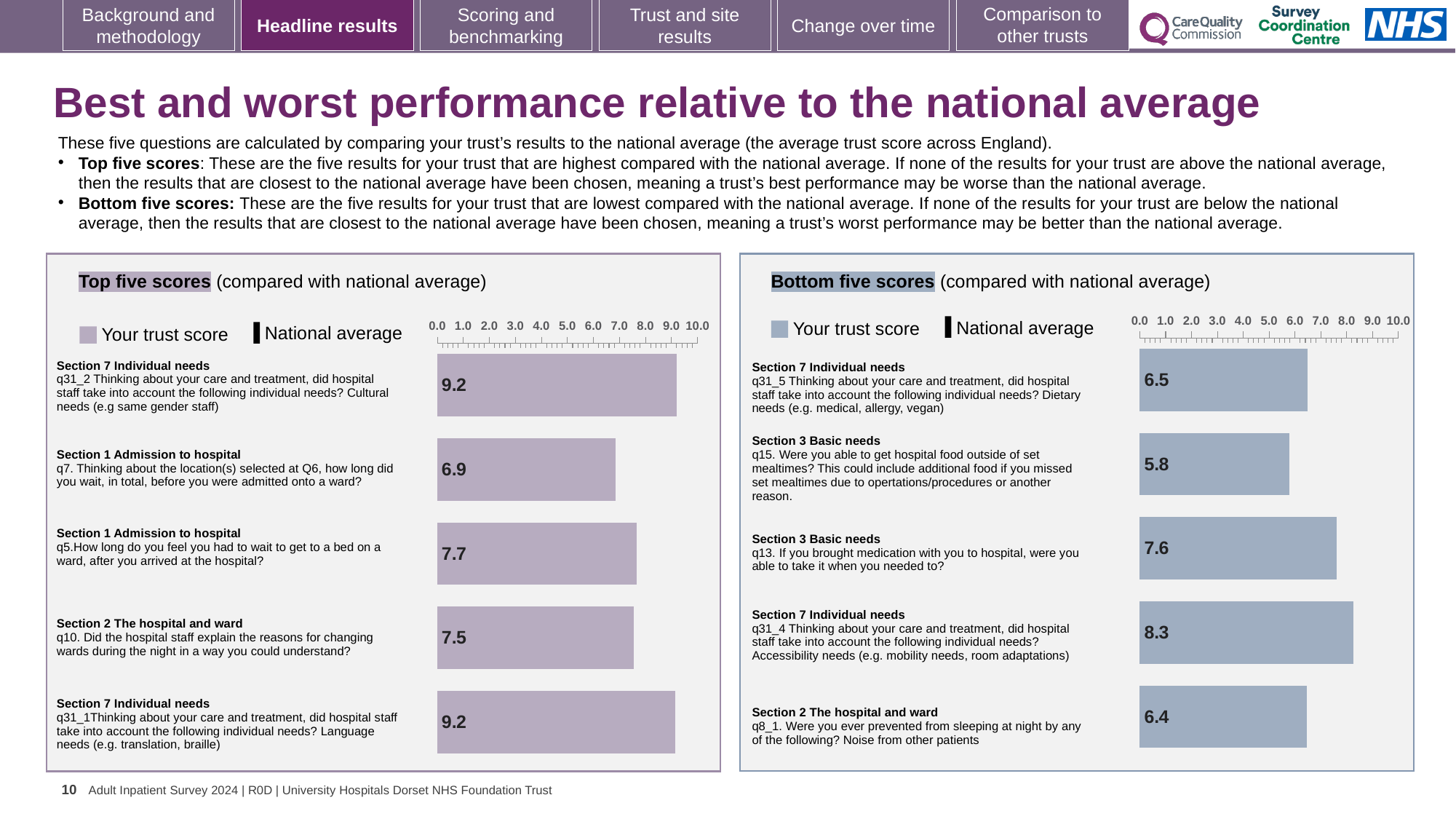
How many bars are plotted in the Top five scores chart? 5 In the Bottom five scores chart, which question has the lowest trust score? q15 (hospital food outside of set mealtimes) In the Top five scores chart, what is the trust score for q10 (did staff explain the reasons for changing wards during the night)? 7.5 In the Bottom five scores chart, what is the trust score for q13 (able to take medication you brought when you needed to)? 7.6 In the Bottom five scores chart, what is the trust score for q8_1 (prevented from sleeping by noise from other patients)? 6.4 In the Bottom five scores chart, which question has the highest trust score? q31_4 (accessibility needs) In the Top five scores chart, what is the trust score for q7 (how long did you wait before being admitted onto a ward)? 6.9 In the Bottom five scores chart, what is the difference between the trust score for q31_4 and the trust score for q15? 2.5 In the Bottom five scores chart, which has the larger trust score: q31_5 (dietary needs) or q8_1 (noise from other patients)? q31_5 (dietary needs) In the Top five scores chart, which question has the lowest trust score? q7 (how long did you wait before being admitted onto a ward) What type of chart is the Bottom five scores chart? Bar chart In the Top five scores chart, what is the difference between the trust score for q5 and the trust score for q7? 0.8